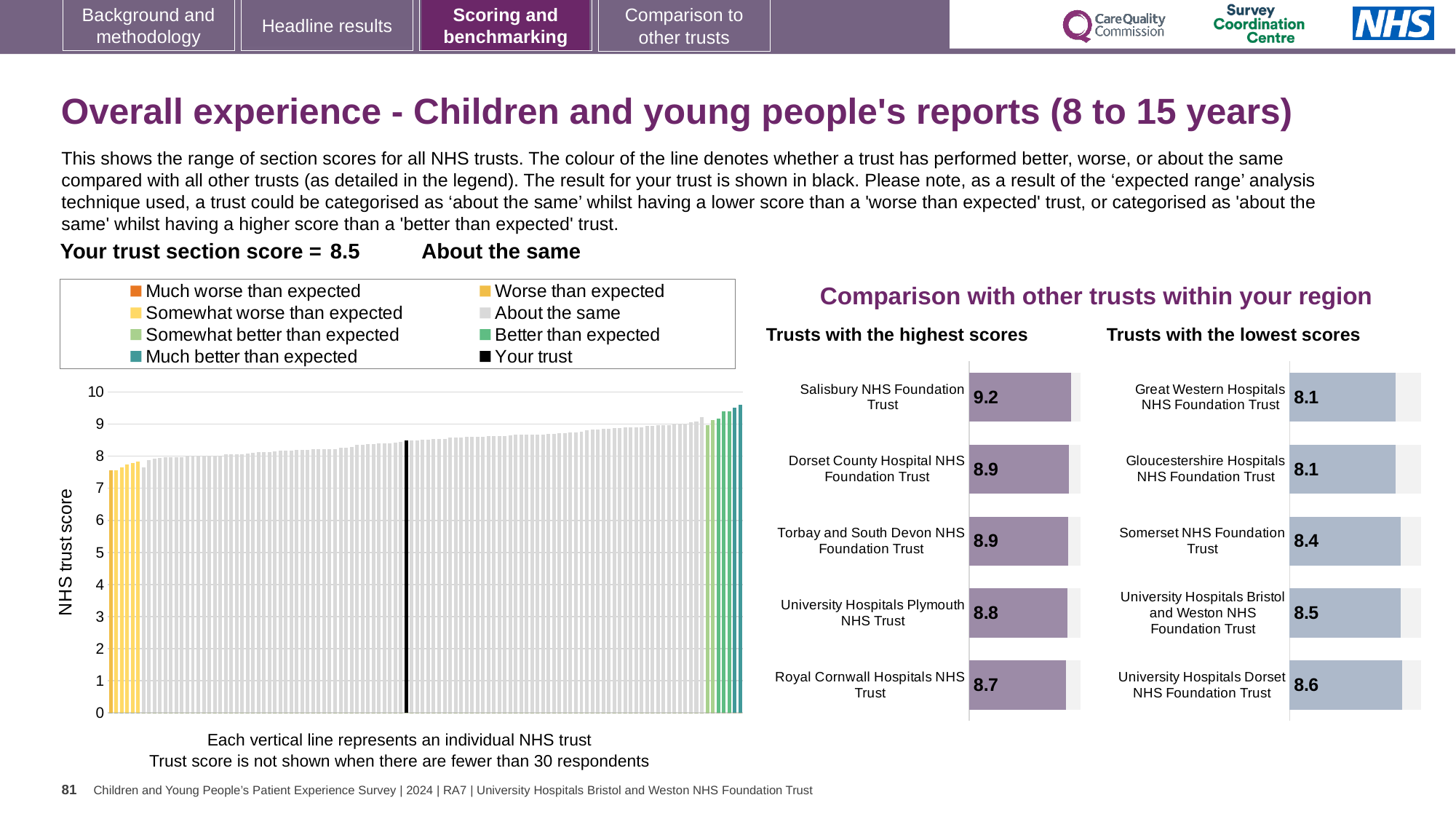
In the 'Trusts with the highest scores' chart, what is the difference between the scores of Salisbury NHS Foundation Trust and Royal Cornwall Hospitals NHS Trust? 0.5 In the 'Trusts with the highest scores' chart, which trust has the highest score? Salisbury NHS Foundation Trust In the 'Trusts with the lowest scores' chart, which has the larger score: Somerset NHS Foundation Trust or University Hospitals Dorset NHS Foundation Trust? University Hospitals Dorset NHS Foundation Trust In the 'NHS trust score' chart on the left, is the value of the black 'Your trust' bar greater or less than 8? greater How many entries does the legend above the 'NHS trust score' chart list? 8 In the 'Trusts with the lowest scores' chart, what is the score for Somerset NHS Foundation Trust? 8.4 In the 'NHS trust score' chart on the left, do the bar values rise or fall from left to right along the x axis? Rise How many trusts are shown in the 'Trusts with the highest scores' chart? 5 In the 'Trusts with the lowest scores' chart, what is the difference between the scores of University Hospitals Dorset NHS Foundation Trust and Great Western Hospitals NHS Foundation Trust? 0.5 What kind of chart is the large 'NHS trust score' chart on the left of the slide? Bar chart In the 'Trusts with the lowest scores' chart, which trust has the highest score? University Hospitals Dorset NHS Foundation Trust In the 'Trusts with the highest scores' chart, what is the score for Salisbury NHS Foundation Trust? 9.2